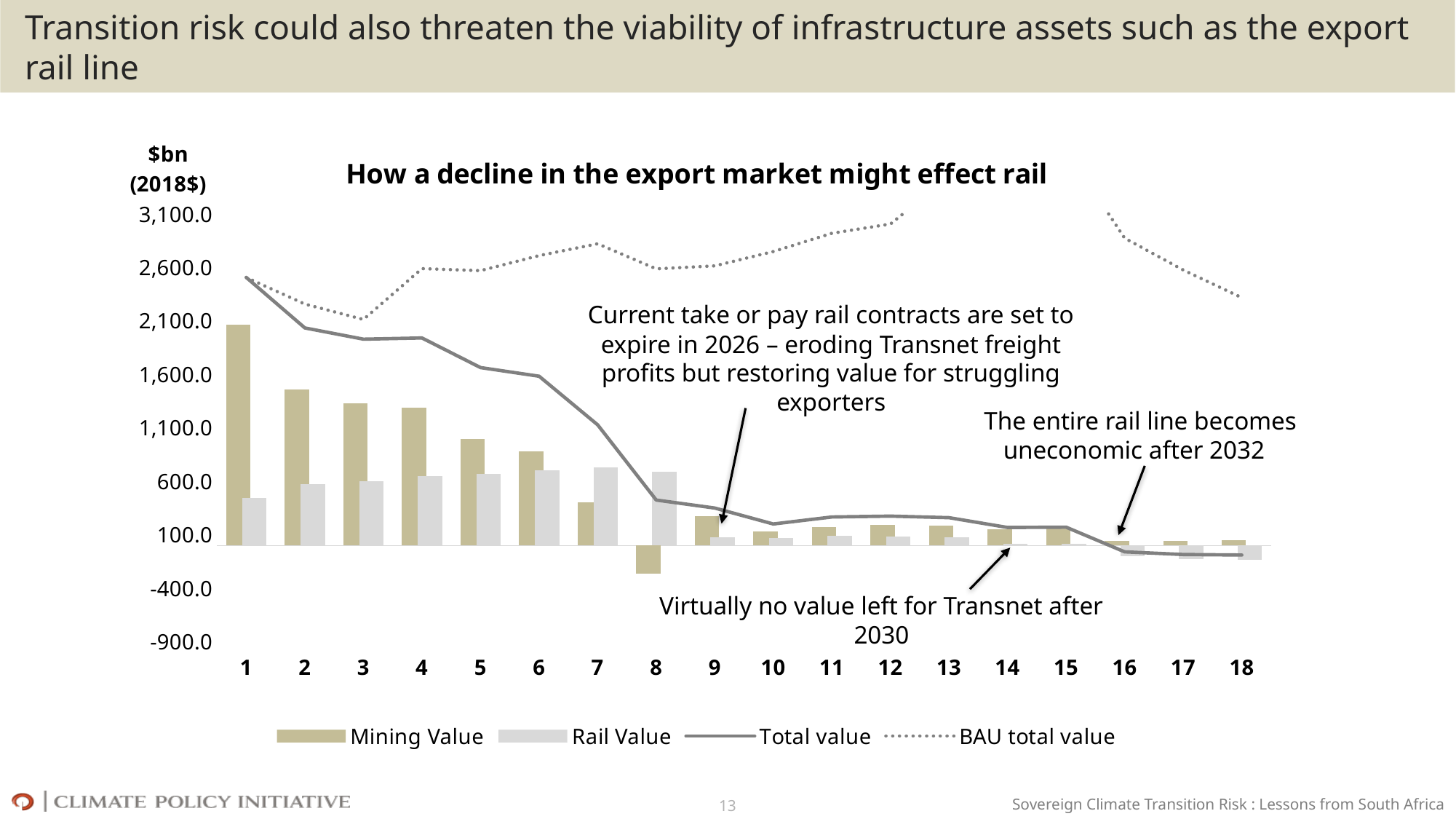
How many categories are shown along the x axis of the chart? 18 What kind of chart is shown on the slide? A combined bar and line chart Which category has the lowest Mining Value? 8 How many series does the chart's legend list? 4 Which category has the highest Mining Value? 1 Is the Rail Value for category 7 greater or less than 600.0? greater Is the Total value for category 1 greater or less than 2,100.0? greater Which is larger, the Mining Value for category 1 or the Mining Value for category 2? Category 1 Is the Mining Value for category 8 greater or less than 100.0? less Does the Total value line generally rise or fall from category 1 to category 18? Fall What is the title of the chart? How a decline in the export market might effect rail